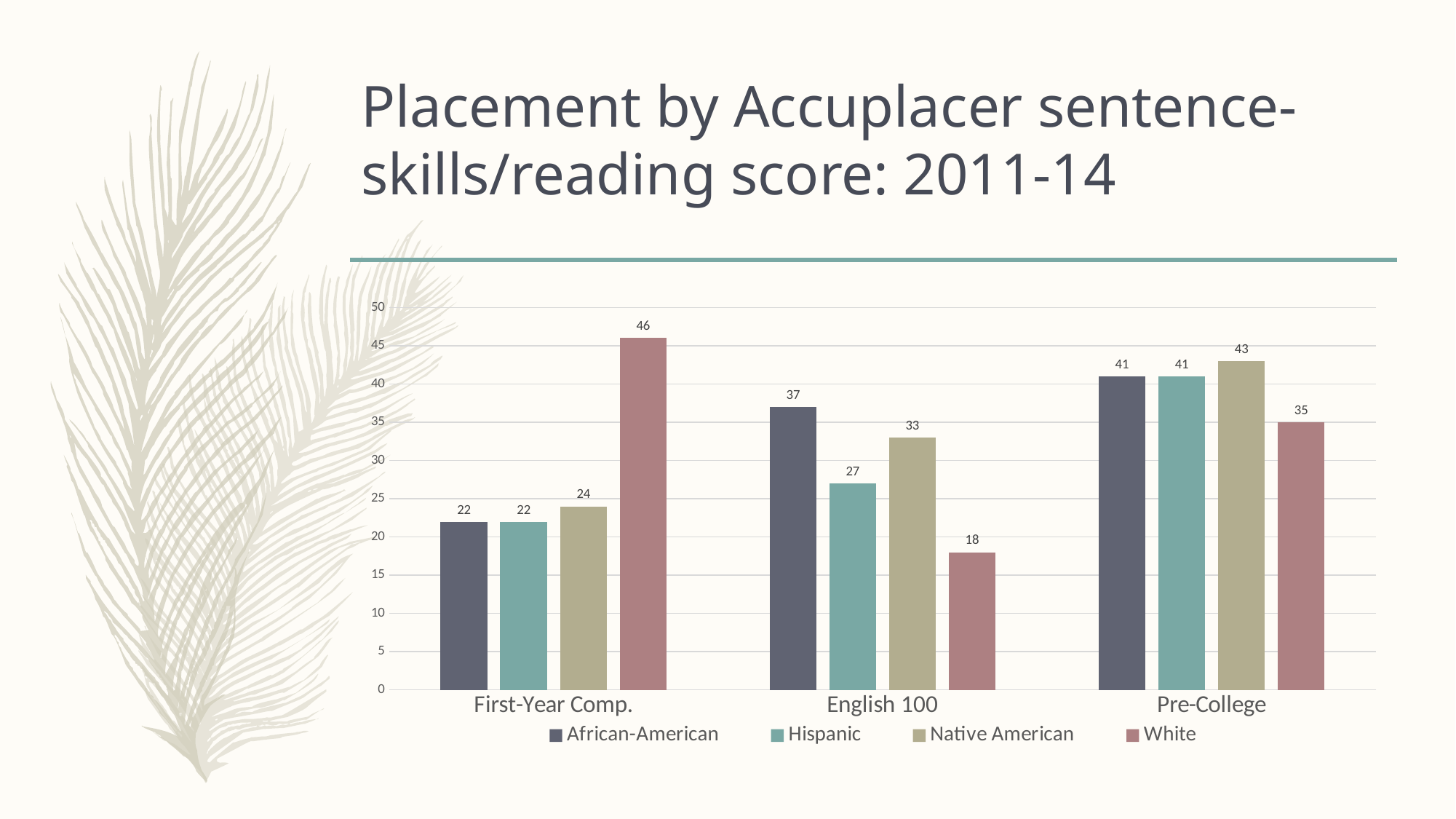
Is the value for White in the English 100 category greater or less than 20? less What is the value for Hispanic in the English 100 category? 27 How many series does the legend list? 4 What is the value for Native American in the Pre-College category? 43 Which series has the lowest value in the Pre-College category? White What is the value for White in the First-Year Comp. category? 46 Which series has the highest value in the English 100 category? African-American Which is larger: the Native American value for English 100 or the White value for English 100? Native American What is the difference between the White value and the African-American value in the First-Year Comp. category? 24 How many categories are shown on the x axis? 3 What kind of chart is shown on the slide? bar chart What is the title of the slide? Placement by Accuplacer sentence-skills/reading score: 2011-14